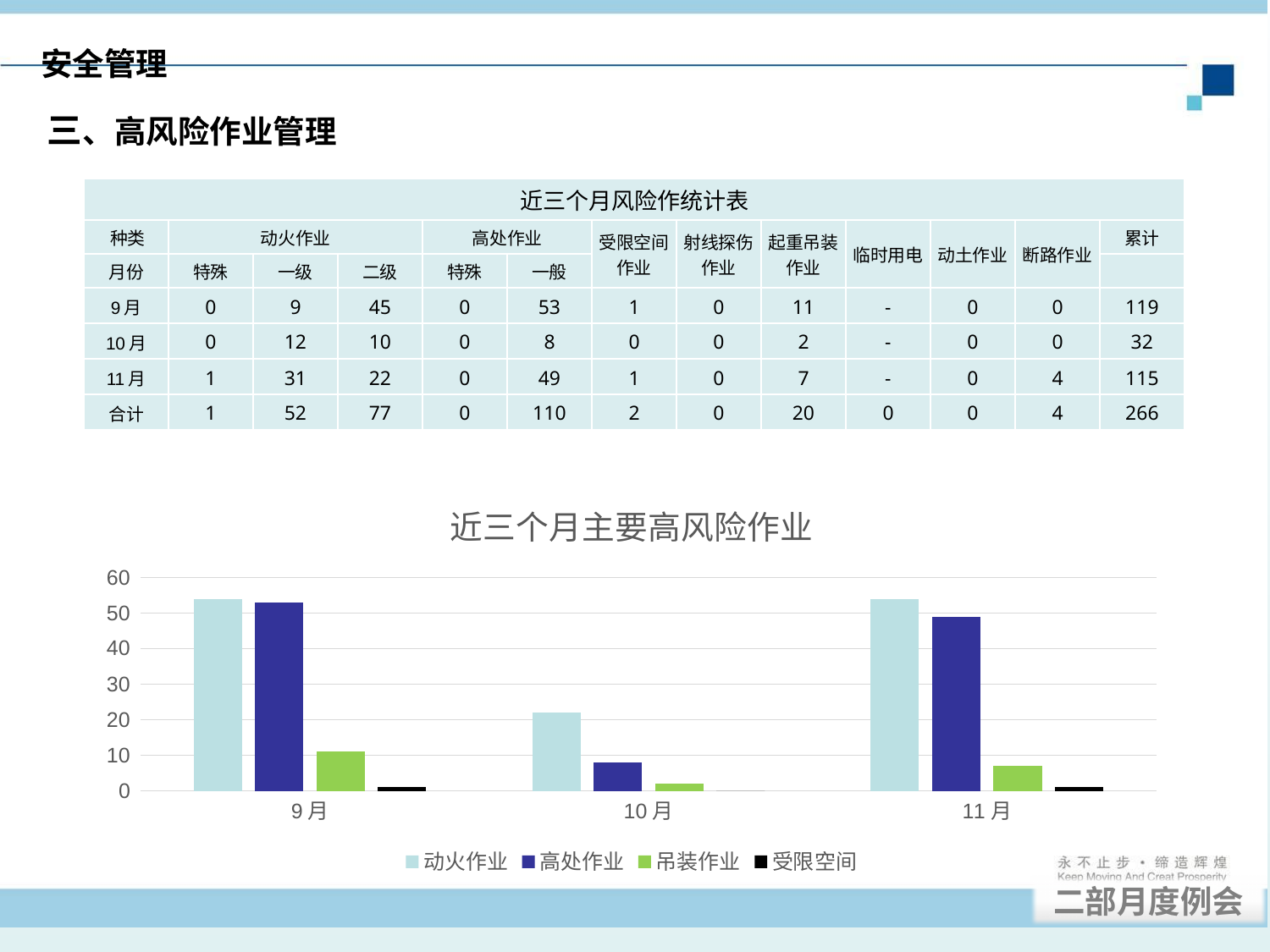
How many series does the chart legend list? 4 What is the title of the chart? 近三个月主要高风险作业 Is the value for 高处作业 in 11月 greater or less than 40? greater Which series has the highest value in 10月? 动火作业 What kind of chart is shown on the slide? bar chart Is the value for 高处作业 in 10月 greater or less than 10? less How many month categories are shown on the x axis of the chart? 3 In 11月, which is larger, 动火作业 or 高处作业? 动火作业 Is the value for 动火作业 in 10月 greater or less than 30? less Which series has the lowest value in 9月? 受限空间 Which colour represents 受限空间 in the chart legend? black